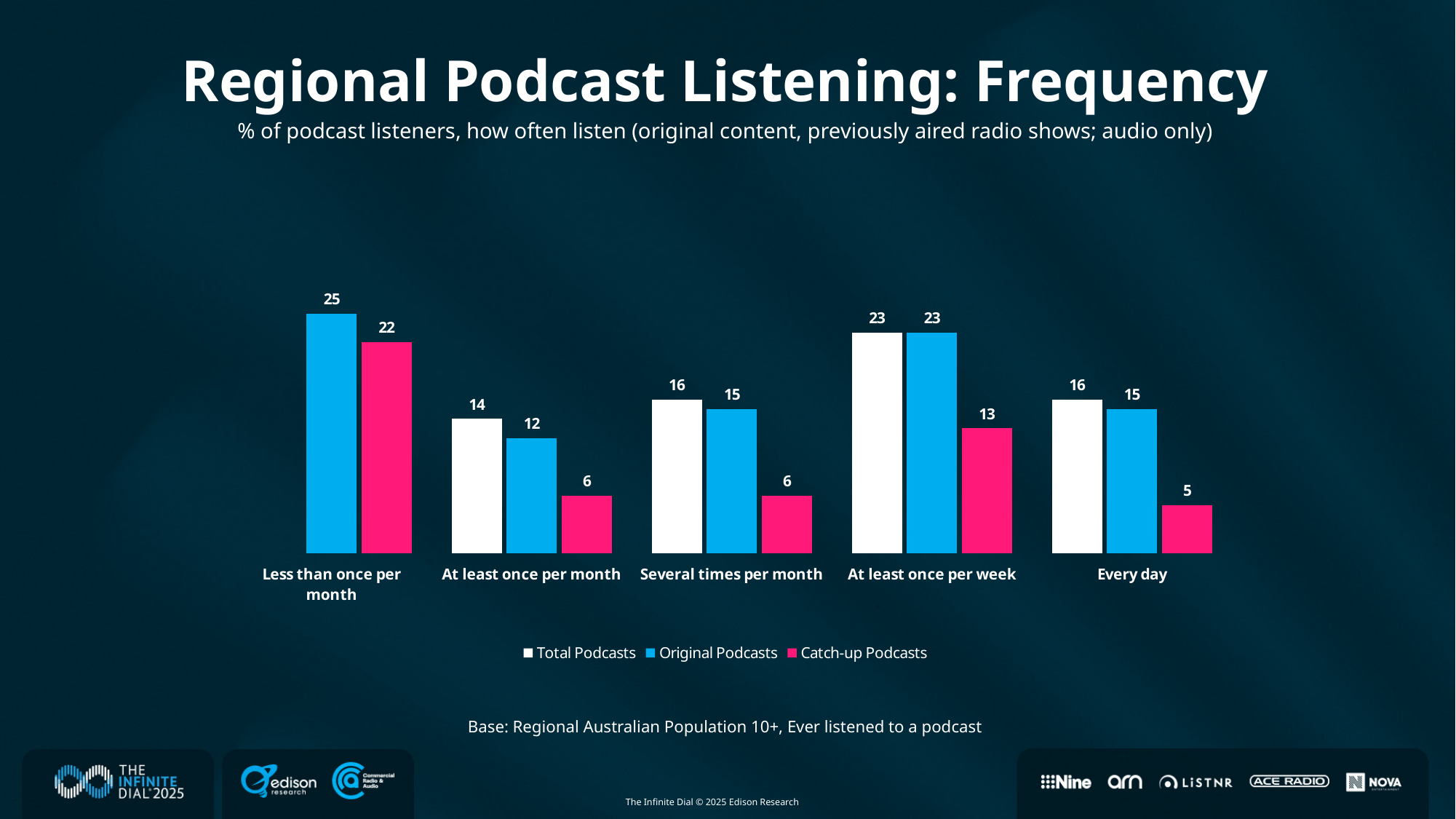
What is the value for Catch-up Podcasts in the 'At least once per week' category? 13 How many frequency categories are shown on the x axis? 5 What is the difference between Total Podcasts and Catch-up Podcasts in the 'At least once per week' category? 10 What kind of chart is shown on the slide? Bar chart What is the difference between Original Podcasts and Catch-up Podcasts in the 'Every day' category? 10 Which is larger: Original Podcasts for 'Several times per month' or Original Podcasts for 'At least once per month'? Several times per month What is the value for Total Podcasts in the 'Every day' category? 16 Which category has the lowest value for Catch-up Podcasts? Every day Which series is shown in pink in the legend? Catch-up Podcasts What is the value for Original Podcasts in the 'Less than once per month' category? 25 How many series does the legend list? 3 Which category has the highest value for Catch-up Podcasts? Less than once per month